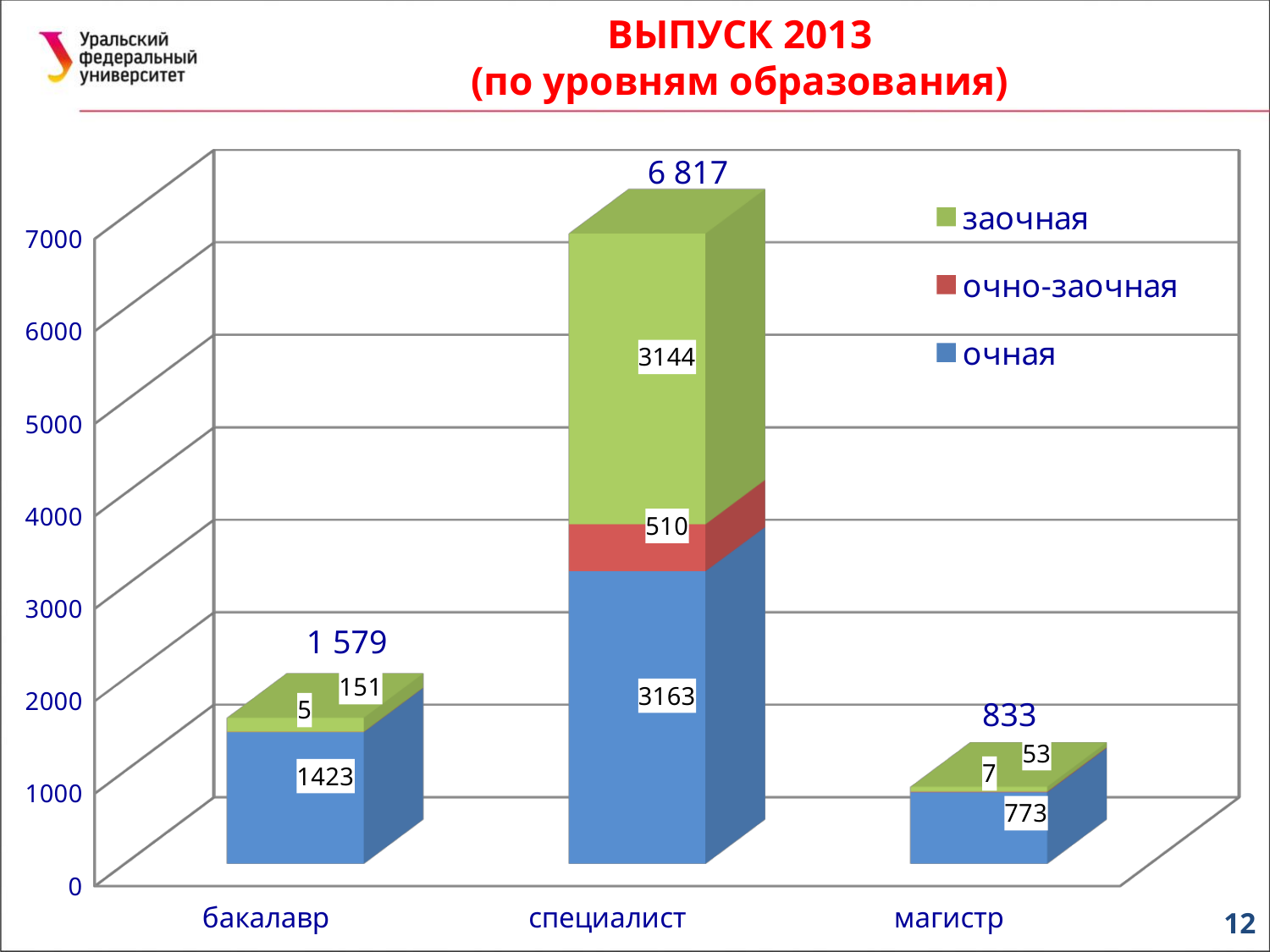
Which category has the highest total? специалист What is the total shown above the магистр bar? 833 What is the value for заочная in the бакалавр category? 151 Which is larger: the заочная value for специалист or the очная value for специалист? очная (3163) What kind of chart is shown on the slide? stacked bar chart What is the total shown above the специалист bar? 6 817 Which category has the lowest total? магистр What is the value for очная in the специалист category? 3163 What is the difference between the очная values for бакалавр and магистр? 650 What is the value for очно-заочная in the магистр category? 7 How many categories are shown on the x axis? 3 How many series does the legend list? 3